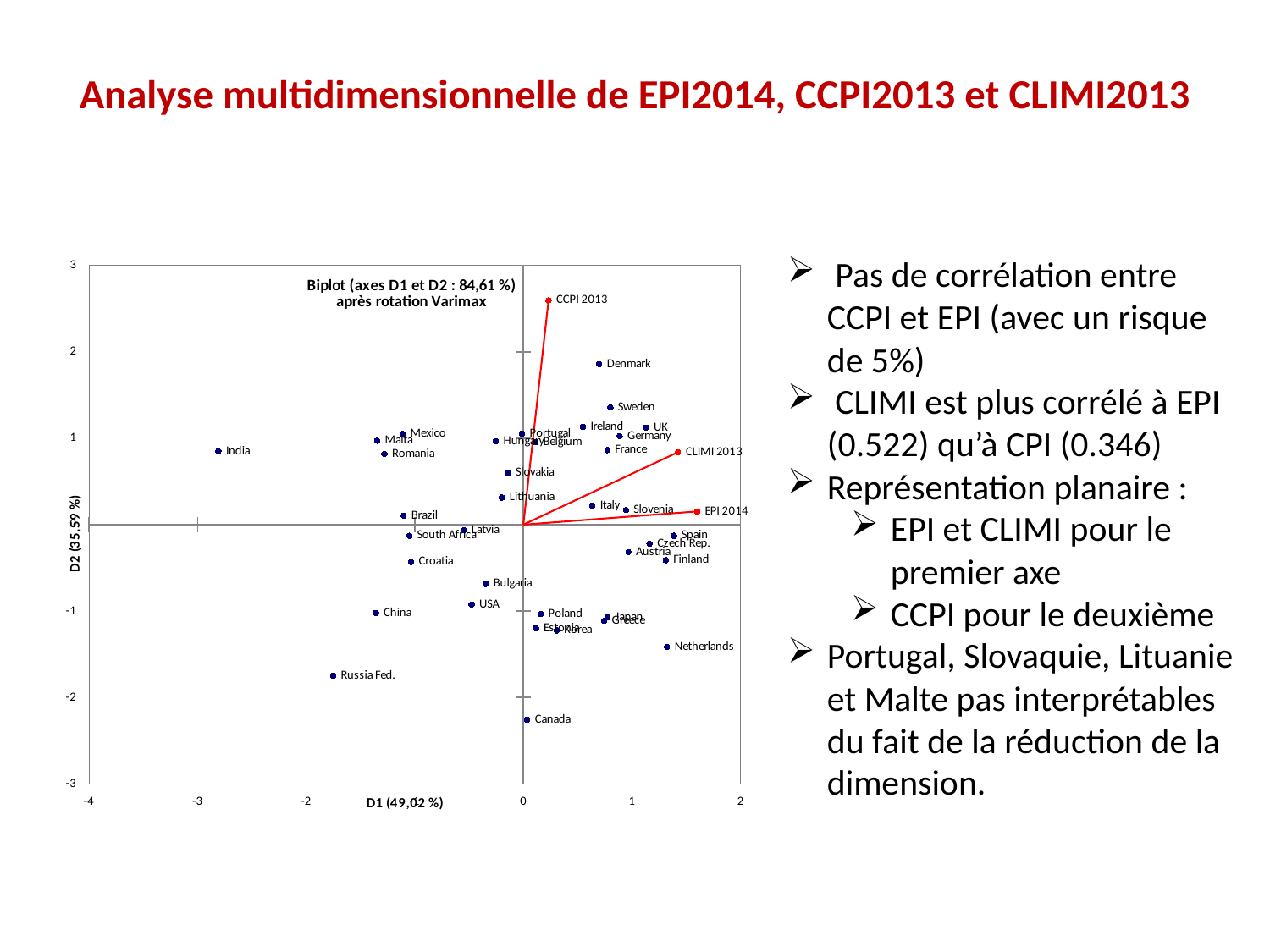
What percentage is shown in the x-axis label for D1? 49,02 % Which country is plotted furthest to the left (lowest D1 value)? India Is the D2 value for the CCPI 2013 vector greater or less than 2? greater Is the D2 value for Canada greater or less than -2? less How many red variable vectors (CCPI 2013, CLIMI 2013, EPI 2014) are drawn on the biplot? 3 What kind of chart is shown on the slide? Scatter plot (biplot) Which has the lower D1 value, India or China? India Which country has the lowest D2 value on the chart? Canada According to the chart title, what percentage of variance do axes D1 and D2 explain together? 84,61 % Is the D2 value for Denmark greater or less than 1? greater Which country has the highest D2 value on the chart? Denmark